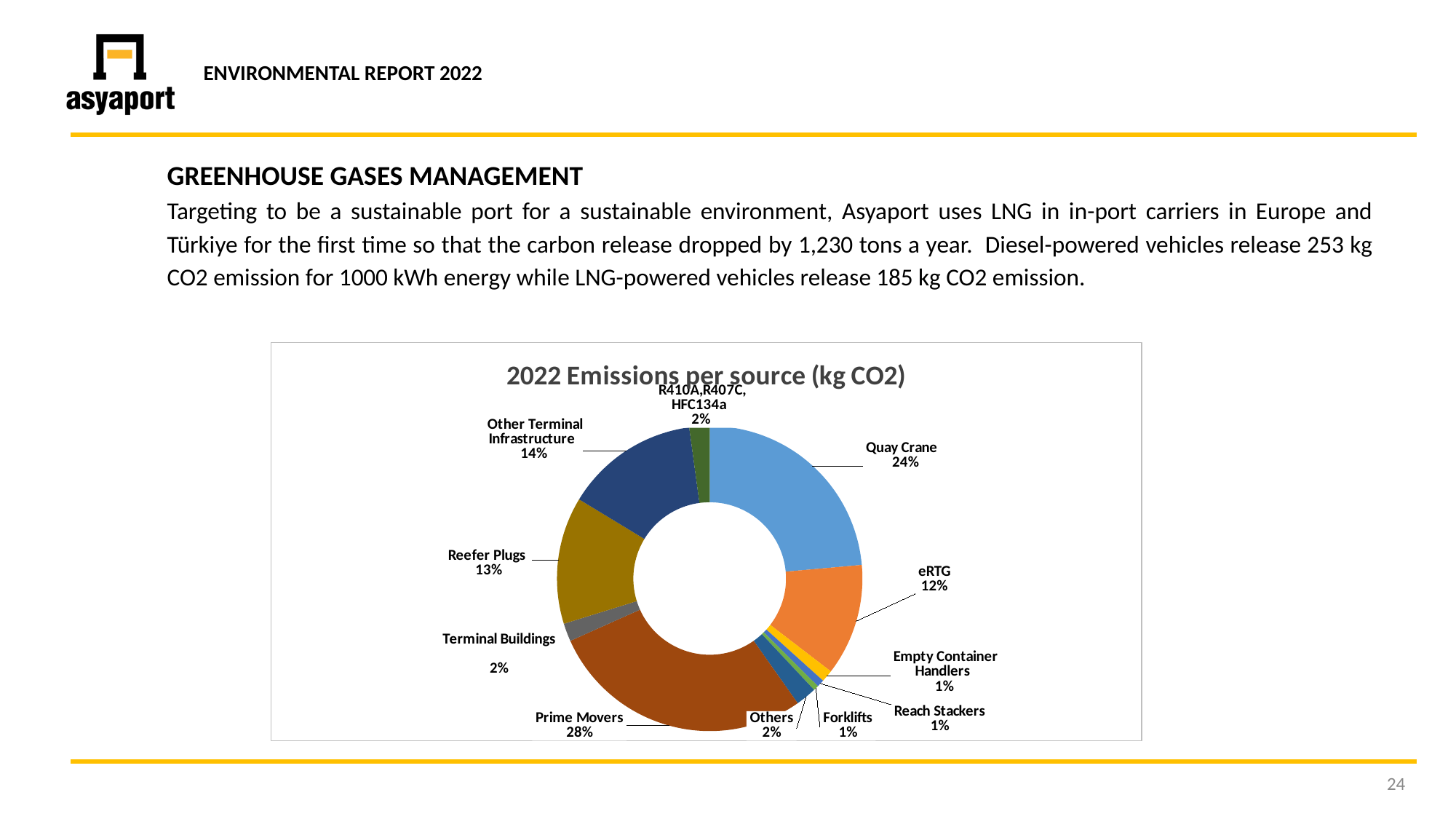
Which source has the largest share of 2022 emissions? Prime Movers Which has a larger share, Reefer Plugs or Other Terminal Infrastructure? Other Terminal Infrastructure How many emission sources are shown in the chart? 11 What share of 2022 emissions does Quay Crane account for? 24% What kind of chart is used to show 2022 emissions per source? Doughnut (pie) chart What is the title of the chart? 2022 Emissions per source (kg CO2) What percentage of emissions is attributed to Prime Movers? 28% How many percentage points larger is the Prime Movers share than the Quay Crane share? 4 What percentage is shown for Other Terminal Infrastructure? 14% What percentage is shown for Terminal Buildings? 2% What share of emissions comes from eRTG? 12% What is the share for Reefer Plugs? 13%